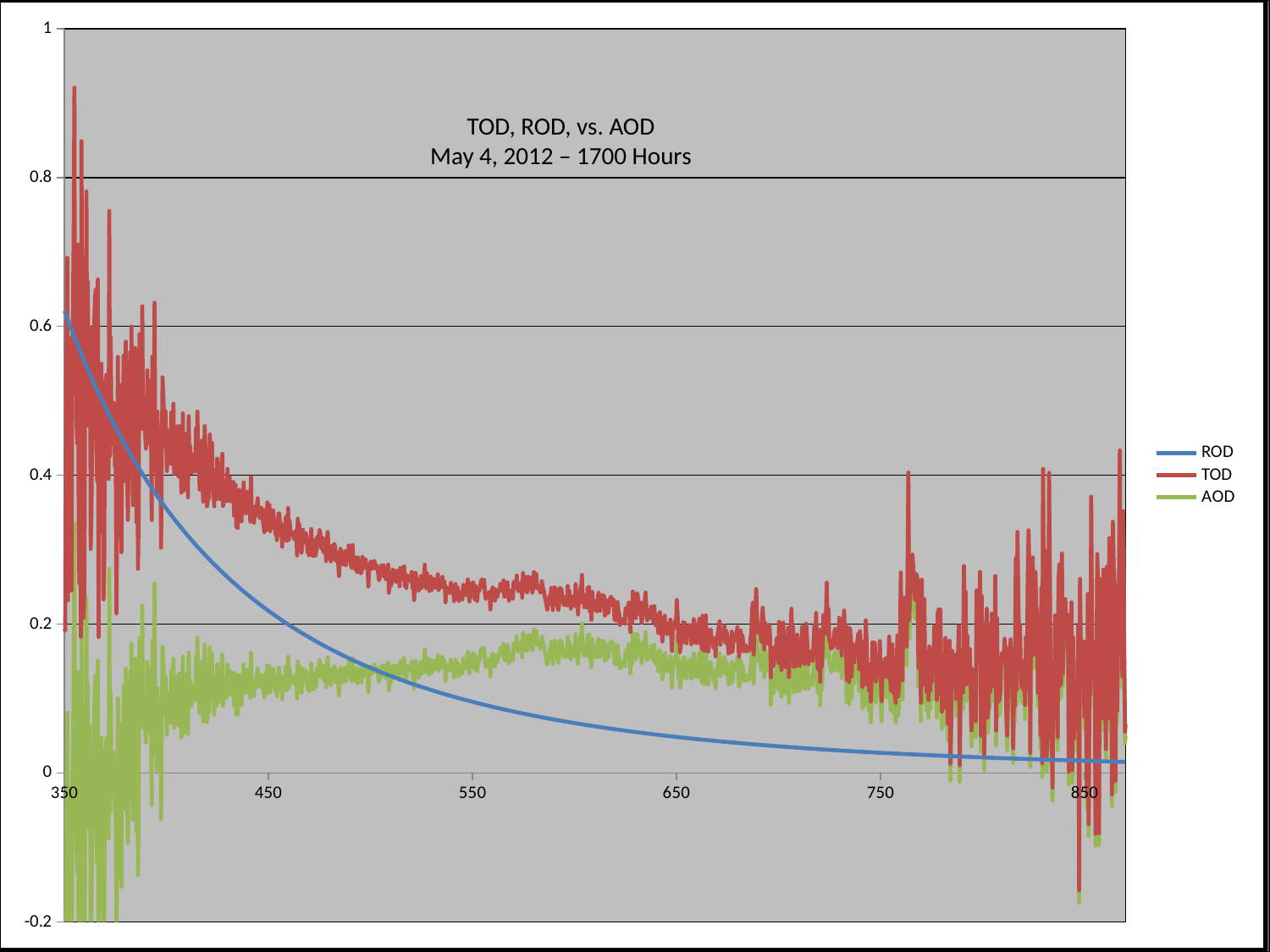
Is the value of ROD at x = 350 greater or less than 0.4? greater Is the value of TOD at x = 550 greater or less than 0.2? greater What kind of chart is shown on the slide? line chart What is the title of the chart? TOD, ROD, vs. AOD May 4, 2012 – 1700 Hours At x = 550, which series has the larger value, TOD or AOD? TOD Which series is drawn as the smooth blue curve? ROD How many series does the legend list? 3 Is the value of ROD at x = 550 greater or less than 0.2? less Does the TOD series generally rise or fall as the x axis increases from 350 to 650? fall At x = 450, which series has the larger value, ROD or TOD? TOD Does the ROD series rise or fall as the x axis increases from 350 to 850? fall